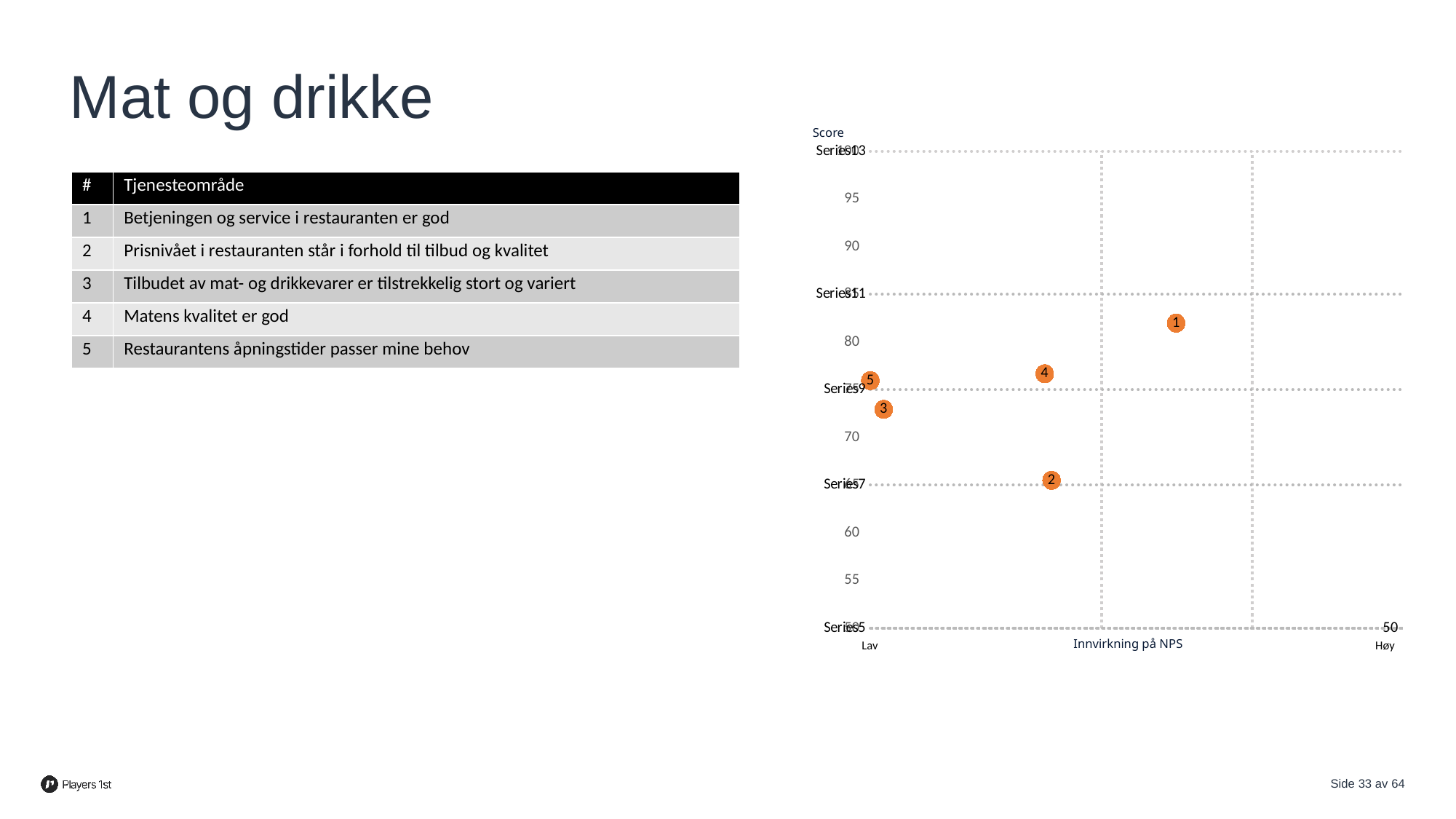
Is the score for point 1 greater or less than 80? greater How many data points are plotted on the chart? 5 Which has the higher score, point 1 or point 2? point 1 Which numbered point has the lowest score on the chart? 2 What kind of chart is shown on the slide? scatter chart What is the title of the horizontal axis of the chart? Innvirkning på NPS Which numbered point has the highest score on the chart? 1 What is the title of the vertical axis of the chart? Score Which has the higher score, point 4 or point 3? point 4 Which numbered point is furthest to the right on the 'Innvirkning på NPS' axis? 1 Is the score for point 2 greater or less than 70? less Is the score for point 3 greater or less than 75? less